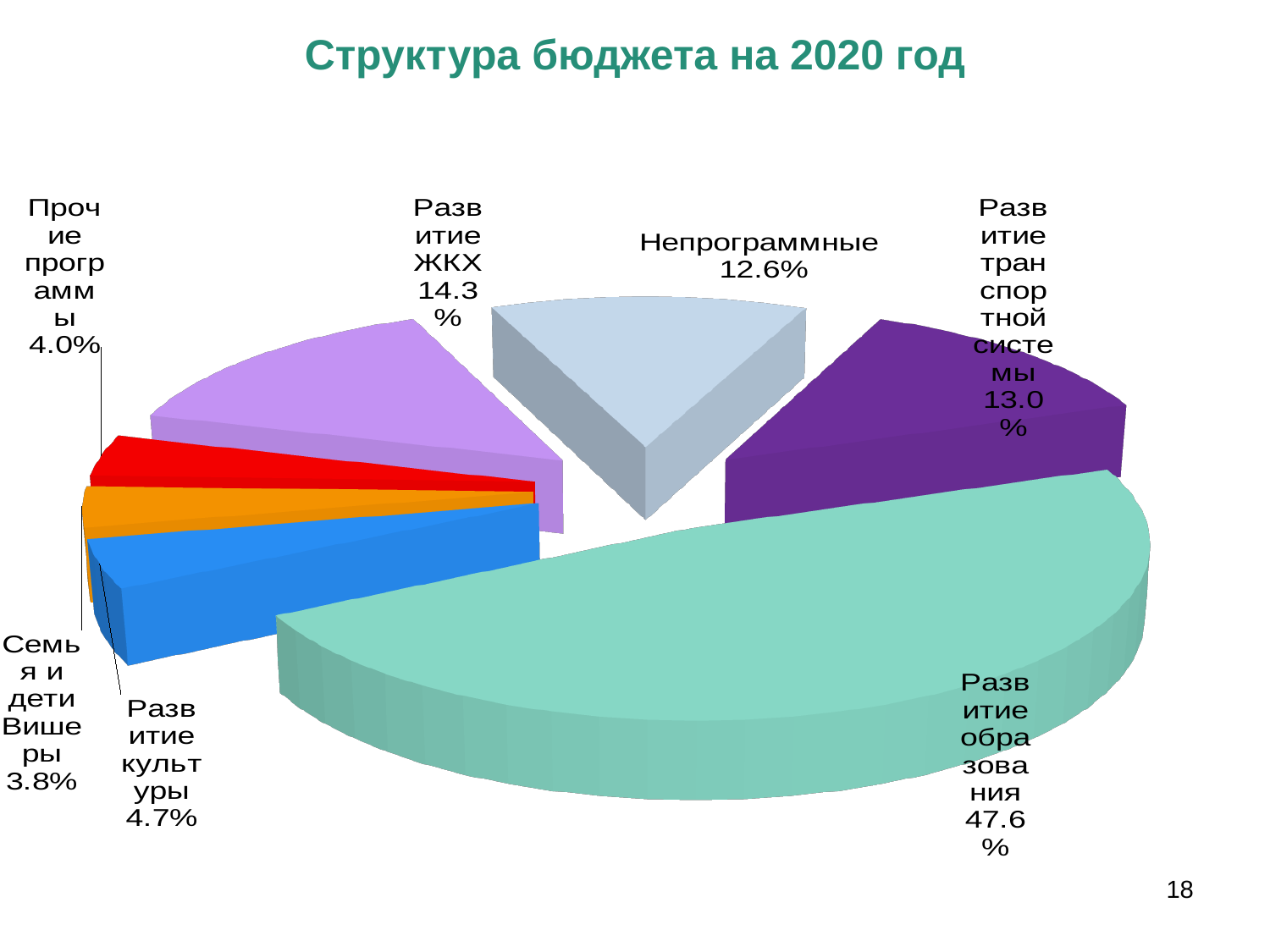
What is the value for Семья и дети Вишеры? 3.8% What is the value for Развитие транспортной системы? 13.0% What is the title of the chart? Структура бюджета на 2020 год What is the value for Непрограммные? 12.6% What is the difference between the shares of Развитие ЖКХ and Непрограммные? 1.7% What share of the budget goes to Развитие образования? 47.6% Which is larger, Развитие культуры or Прочие программы? Развитие культуры What type of chart is shown on the slide? pie chart Which category has the smallest share of the budget? Семья и дети Вишеры How many slices does the pie chart have? 7 What is the value for Развитие ЖКХ? 14.3% Which category has the largest share of the budget? Развитие образования